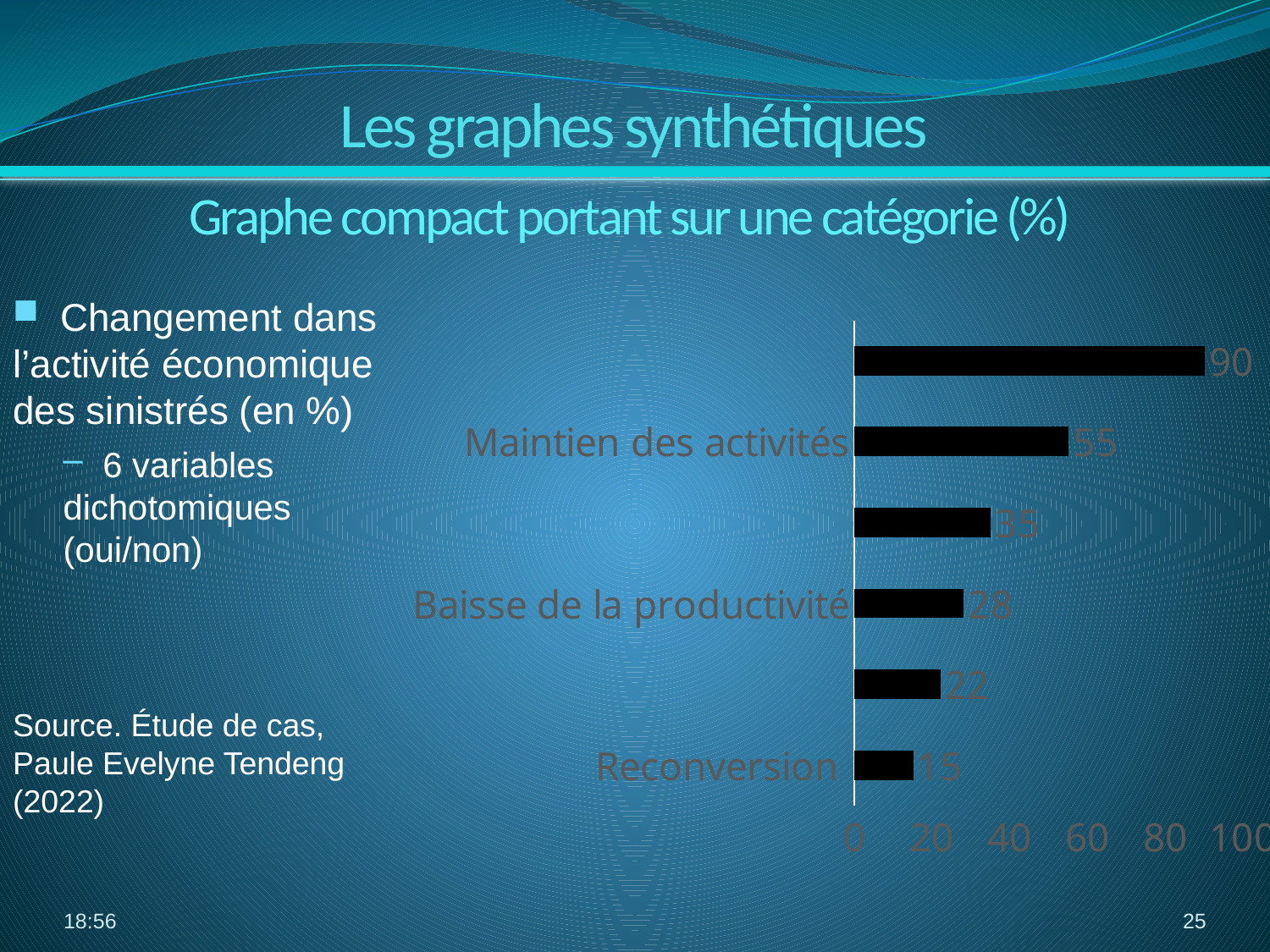
What is the difference between the values for "Maintien des activités" and "Baisse de la productivité"? 27 What is the highest value shown on the chart? 90 What is the value for "Reconversion"? 15 Is the value for "Baisse de la productivité" greater or less than 40? less How many bars are plotted on the chart? 6 What is the value for "Baisse de la productivité"? 28 What is the difference between the values for "Baisse de la productivité" and "Reconversion"? 13 Which is larger, the value for "Maintien des activités" or the value for "Reconversion"? Maintien des activités What is the maximum value shown on the horizontal axis? 100 What kind of chart is shown on the slide? bar chart What is the value for "Maintien des activités"? 55 Which category has the lowest value? Reconversion